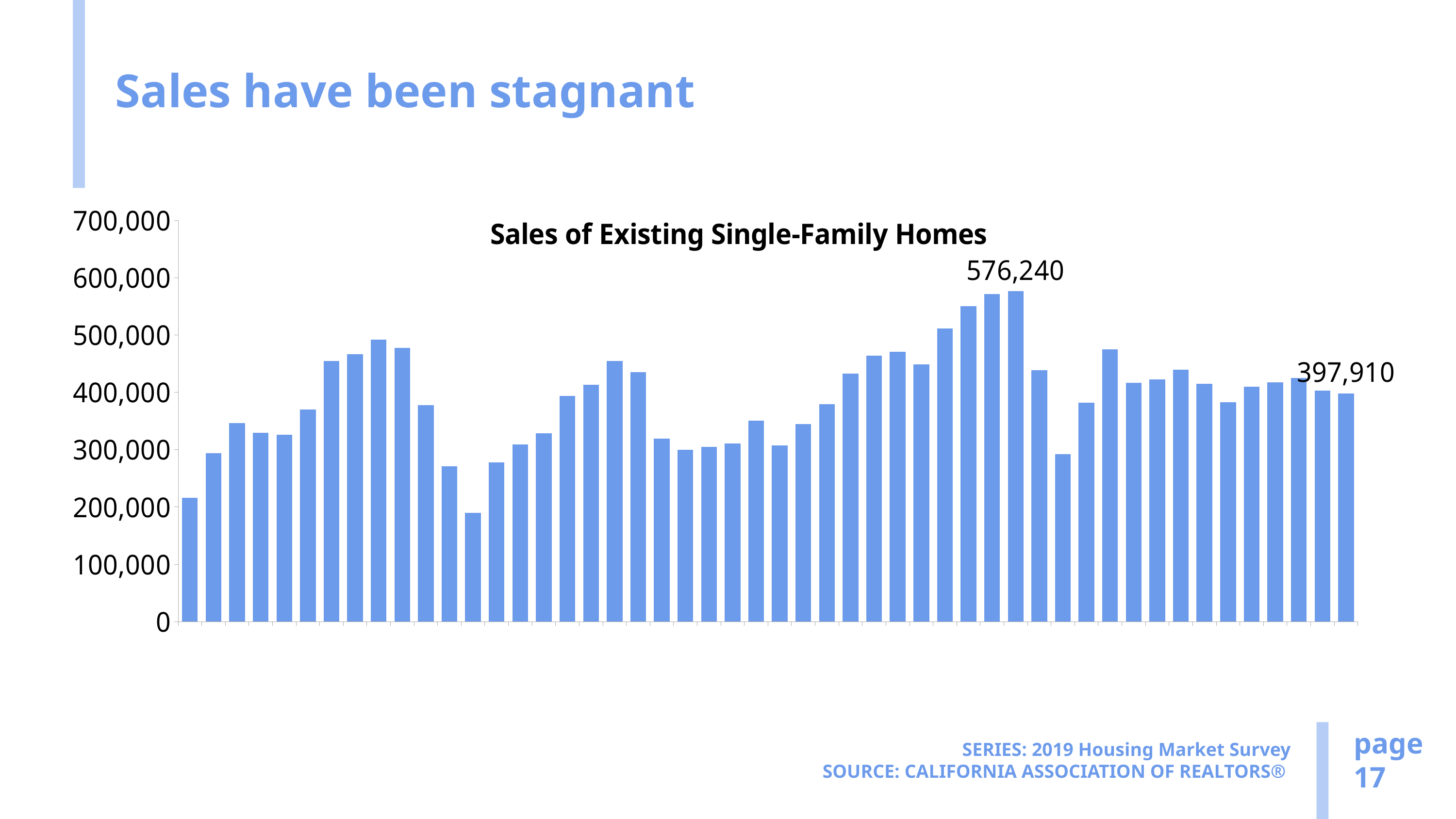
Which is larger: the value of the highest bar or the value of the last bar? the highest bar (576,240) What is the value of the last (rightmost) bar in the chart? 397,910 What is the maximum value shown on the vertical axis? 700,000 Is the value of the first (leftmost) bar greater or less than 300,000? less Is the value of the highest bar greater or less than 500,000? greater What kind of chart is shown on the slide? bar chart What is the title of the chart? Sales of Existing Single-Family Homes What is the value of the highest bar in the chart? 576,240 What is the difference between the highest bar's value (576,240) and the last bar's value (397,910)? 178,330 Is the value of the lowest bar greater or less than 300,000? less